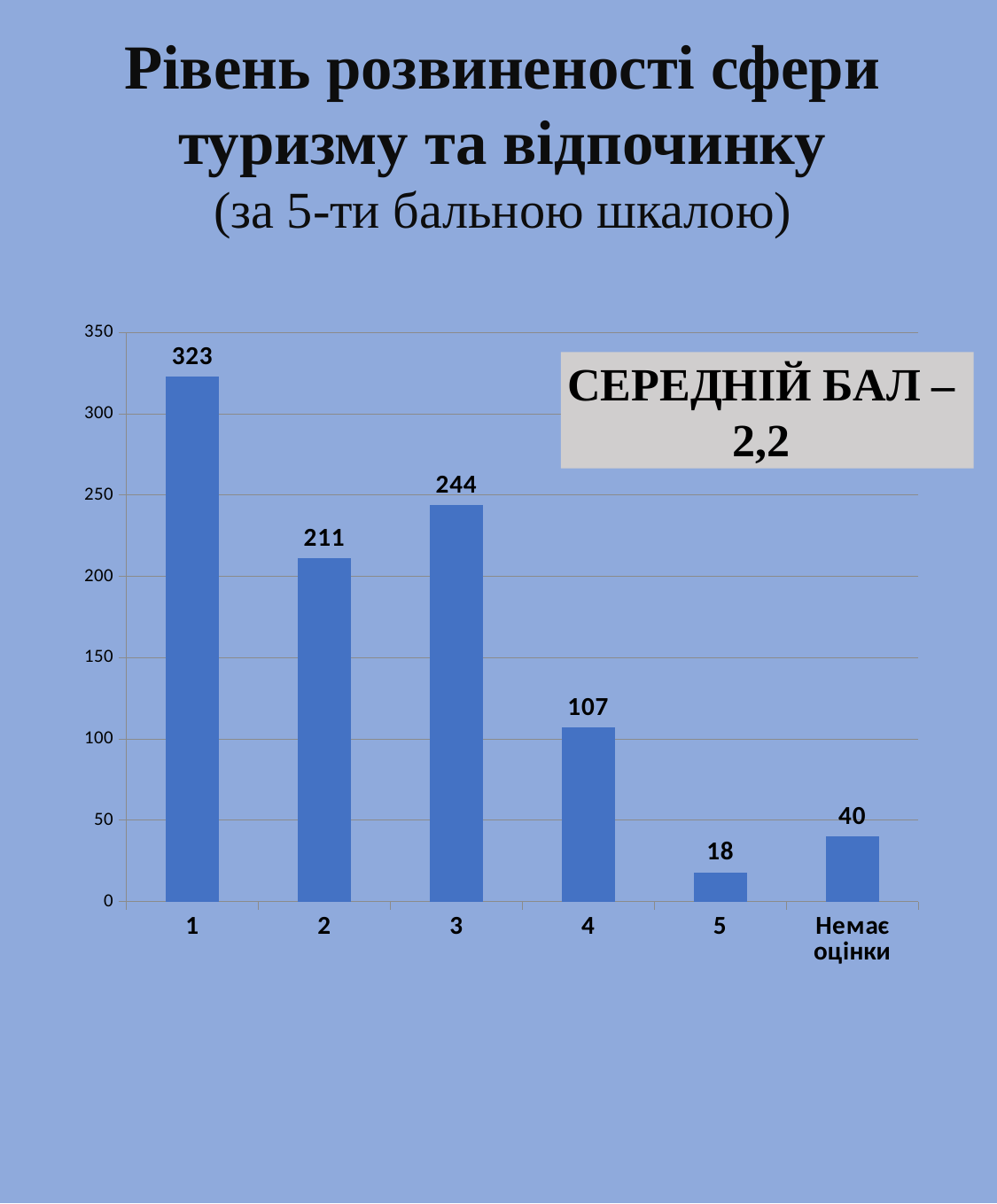
Which category has the lowest value? 5 What is the difference between the values for category 4 and category 5? 89 What kind of chart is shown on the slide? bar chart Which is larger, the value for category 2 or category 3? 3 Is the value for category 4 greater or less than 150? less What is the value for the "Немає оцінки" category? 40 Which category has the highest value? 1 What is the difference between the values for category 1 and category 2? 112 What is the value for category 1? 323 What average score (середній бал) is stated in the box on the slide? 2,2 How many categories are shown on the x axis? 6 What is the value for category 3? 244